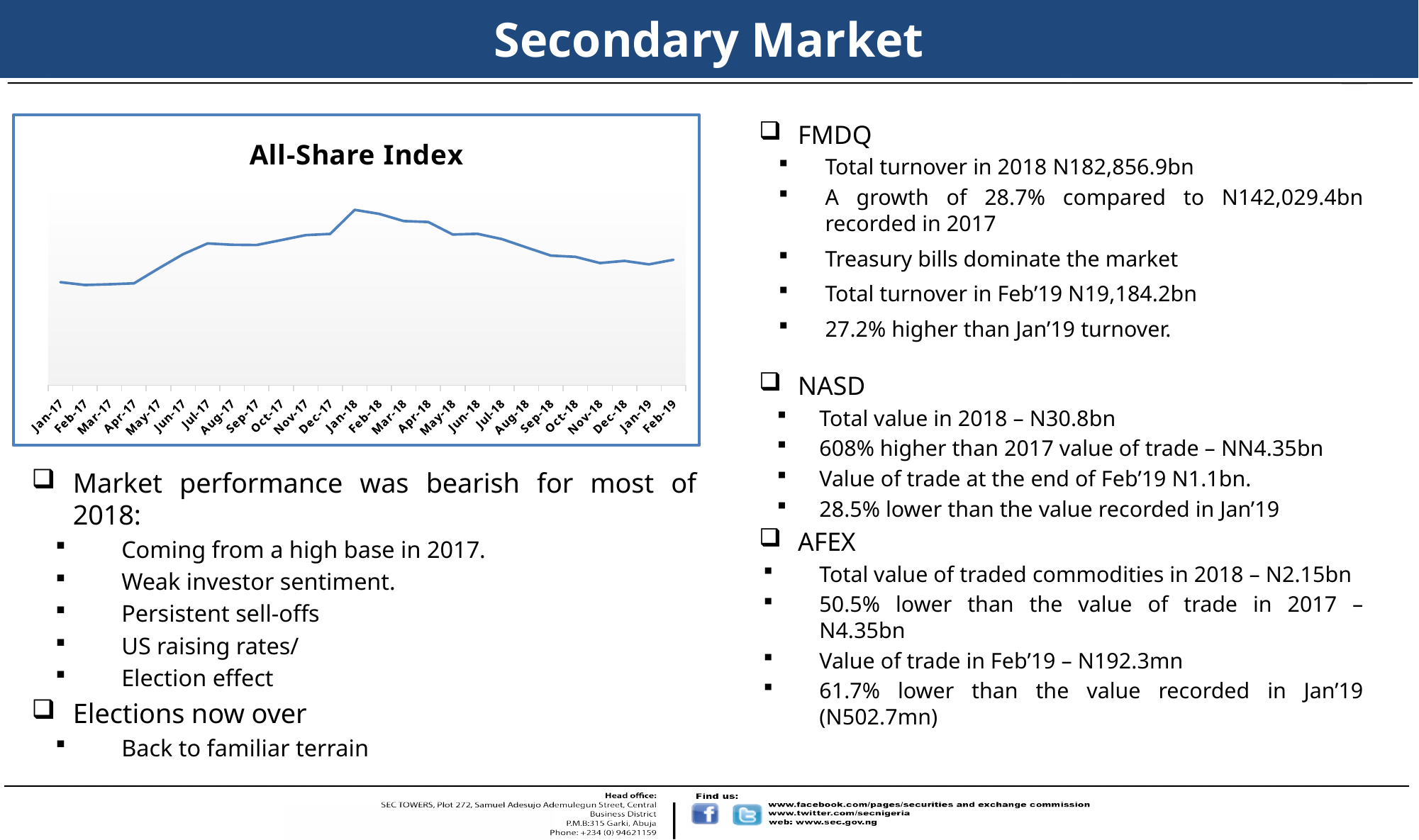
How many lines are plotted on the All-Share Index chart? 1 Which is higher on the All-Share Index chart, Apr-18 or Dec-18? Apr-18 In which month does the All-Share Index reach its highest point on the chart? Jan-18 What is the title of the chart on the slide? All-Share Index Does the All-Share Index rise or fall between Jan-18 and Feb-19? fall What is the first month shown on the x axis of the All-Share Index chart? Jan-17 How many monthly points are plotted on the All-Share Index chart? 26 Which is higher on the All-Share Index chart, Jan-17 or Feb-19? Feb-19 Does the All-Share Index rise or fall between Jan-17 and Jan-18? rise What kind of chart is the All-Share Index chart? line chart Which is higher on the All-Share Index chart, Jan-18 or Feb-19? Jan-18